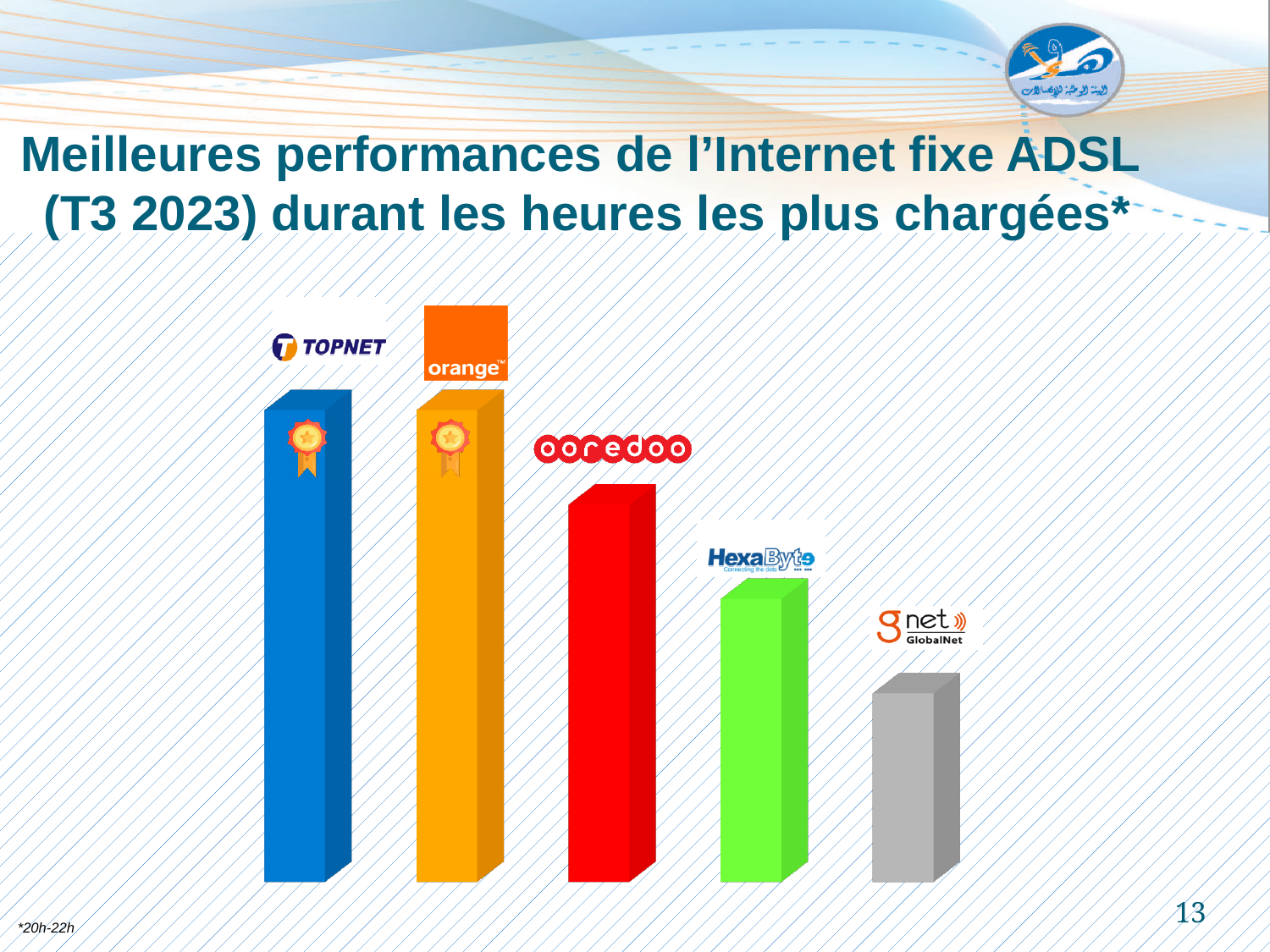
Which bar is taller, Ooredoo or HexaByte? Ooredoo How many bars (operators) are shown in the chart? 5 Which operator is represented by the red bar? Ooredoo Which two operators have a medal badge on their bars? TOPNET and Orange Do the bar heights rise or fall from left to right across the chart? fall Which bar is taller, HexaByte or GlobalNet? HexaByte Which bar is taller, Orange or Ooredoo? Orange Which operator has the lowest bar in the chart? GlobalNet What kind of chart is shown on the slide? bar chart